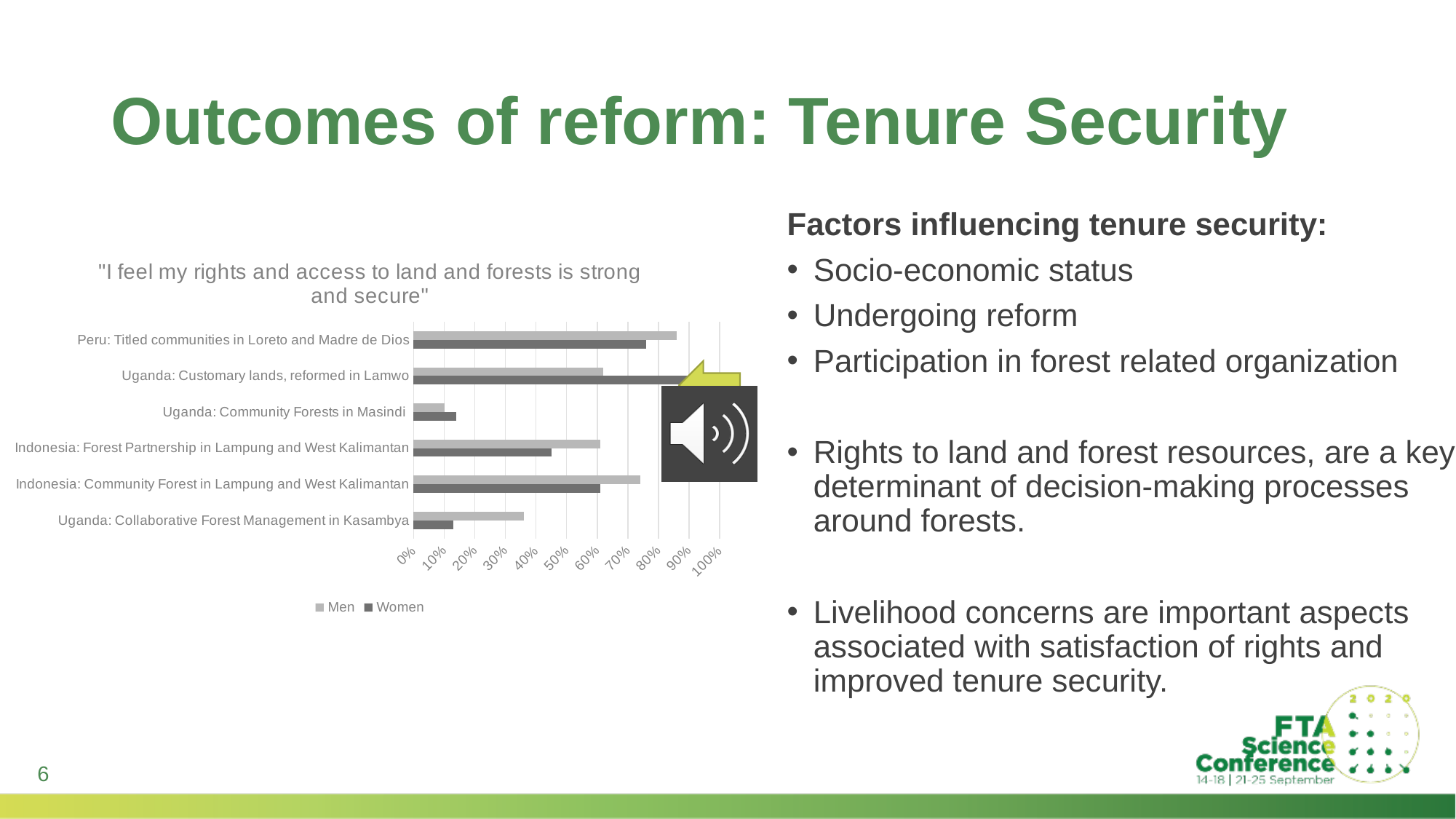
What kind of chart is shown on the slide? Bar chart Which category has the lowest value for Men? Uganda: Community Forests in Masindi Is the Men value for Peru: Titled communities in Loreto and Madre de Dios greater or less than 80%? greater For Uganda: Customary lands, reformed in Lamwo, which is larger, the Men value or the Women value? Women What is the title of the chart? "I feel my rights and access to land and forests is strong and secure" Is the Women value for Uganda: Collaborative Forest Management in Kasambya greater or less than 20%? less What are the two series named in the chart legend? Men and Women How many categories (sites) are plotted in the chart? 6 Which category has the highest value for Men? Peru: Titled communities in Loreto and Madre de Dios For Uganda: Collaborative Forest Management in Kasambya, which is larger, the Men value or the Women value? Men Which category has the highest value for Women? Uganda: Customary lands, reformed in Lamwo How many series does the chart legend list? 2